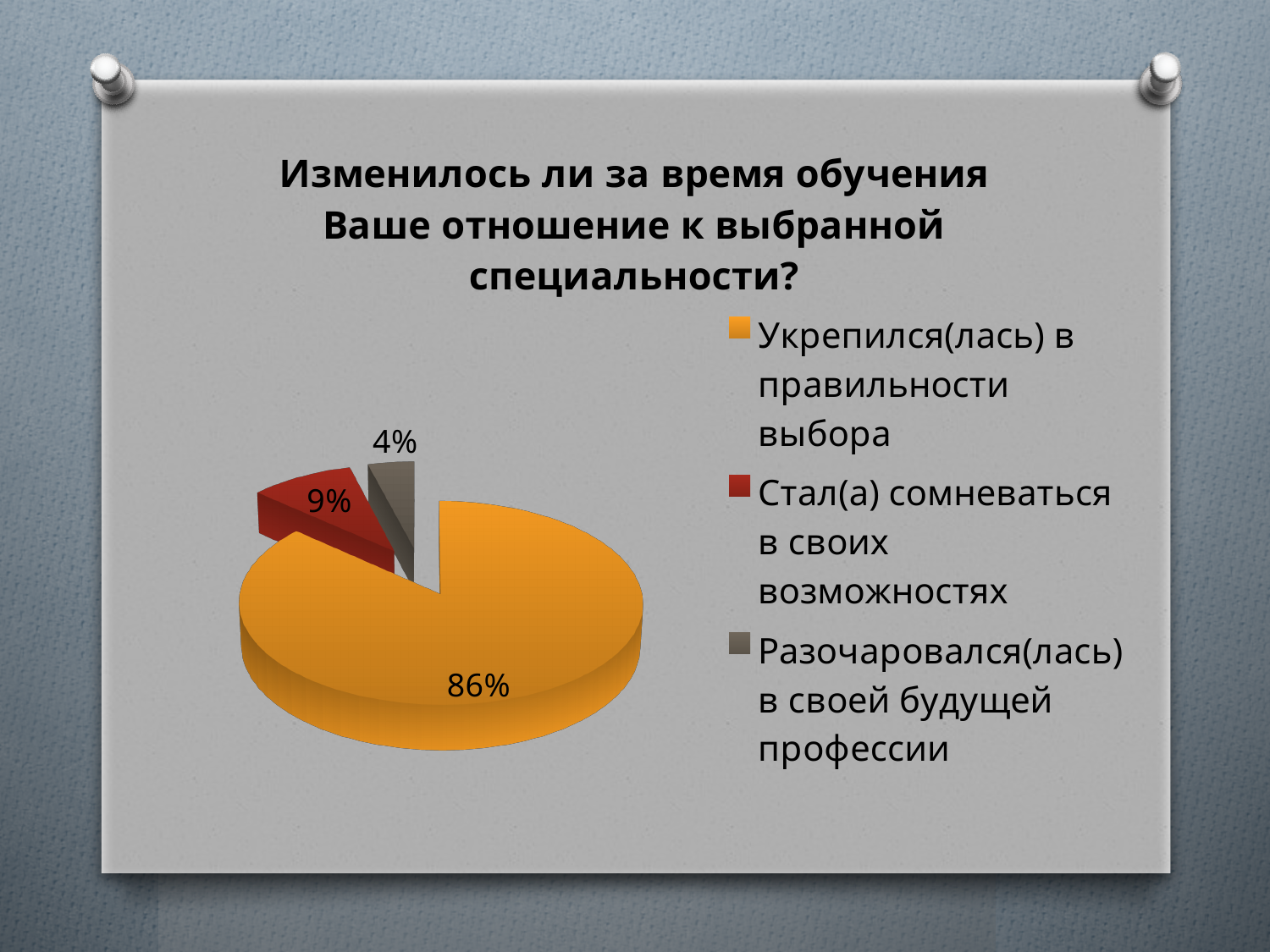
What share of the pie is labelled "Разочаровался(лась) в своей будущей профессии"? 4% Which category has the largest slice of the pie? Укрепился(лась) в правильности выбора What share of the pie is labelled "Стал(а) сомневаться в своих возможностях"? 9% What is the difference in percentage points between the "Укрепился(лась) в правильности выбора" slice and the "Стал(а) сомневаться в своих возможностях" slice? 77 What is the title of the chart? Изменилось ли за время обучения Ваше отношение к выбранной специальности? What kind of chart is shown on the slide? Pie chart What colour is the slice for "Стал(а) сомневаться в своих возможностях"? Red What share of the pie is labelled "Укрепился(лась) в правильности выбора"? 86% What is the difference in percentage points between the "Стал(а) сомневаться в своих возможностях" slice and the "Разочаровался(лась) в своей будущей профессии" slice? 5 How many categories does the pie chart have? 3 Which is larger: the "Стал(а) сомневаться в своих возможностях" slice or the "Разочаровался(лась) в своей будущей профессии" slice? Стал(а) сомневаться в своих возможностях Which category has the smallest slice of the pie? Разочаровался(лась) в своей будущей профессии